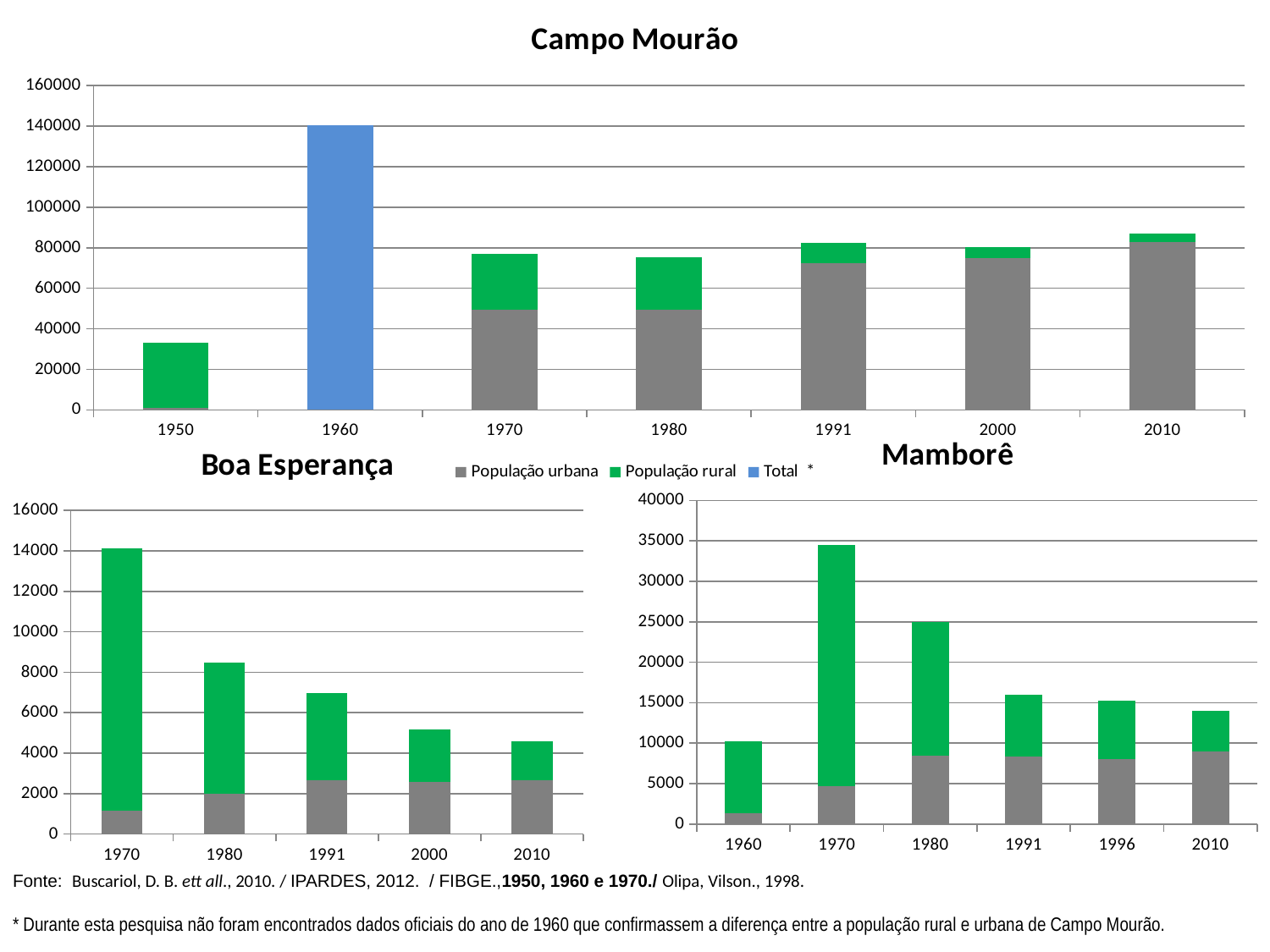
In the Mamborê chart, which bar is taller, 1980 or 1991? 1980 In the Mamborê chart, which year has the tallest bar? 1970 What kind of chart is the Boa Esperança chart? Stacked bar chart In the Campo Mourão chart, is the total bar for 1960 greater or less than 120000? greater In the Campo Mourão chart, is the total bar for 1950 greater or less than 40000? less How many series does the legend of the Campo Mourão chart list? 3 In the Campo Mourão chart, which year has the shortest bar? 1950 In the Boa Esperança chart, is the total bar for 1970 greater or less than 12000? greater In the Boa Esperança chart, do the total bar heights rise or fall from 1970 to 2010? Fall In the Mamborê chart, which year has the shortest bar? 1960 How many years are shown on the x axis of the Campo Mourão chart? 7 In the Campo Mourão chart, which year has the tallest bar? 1960